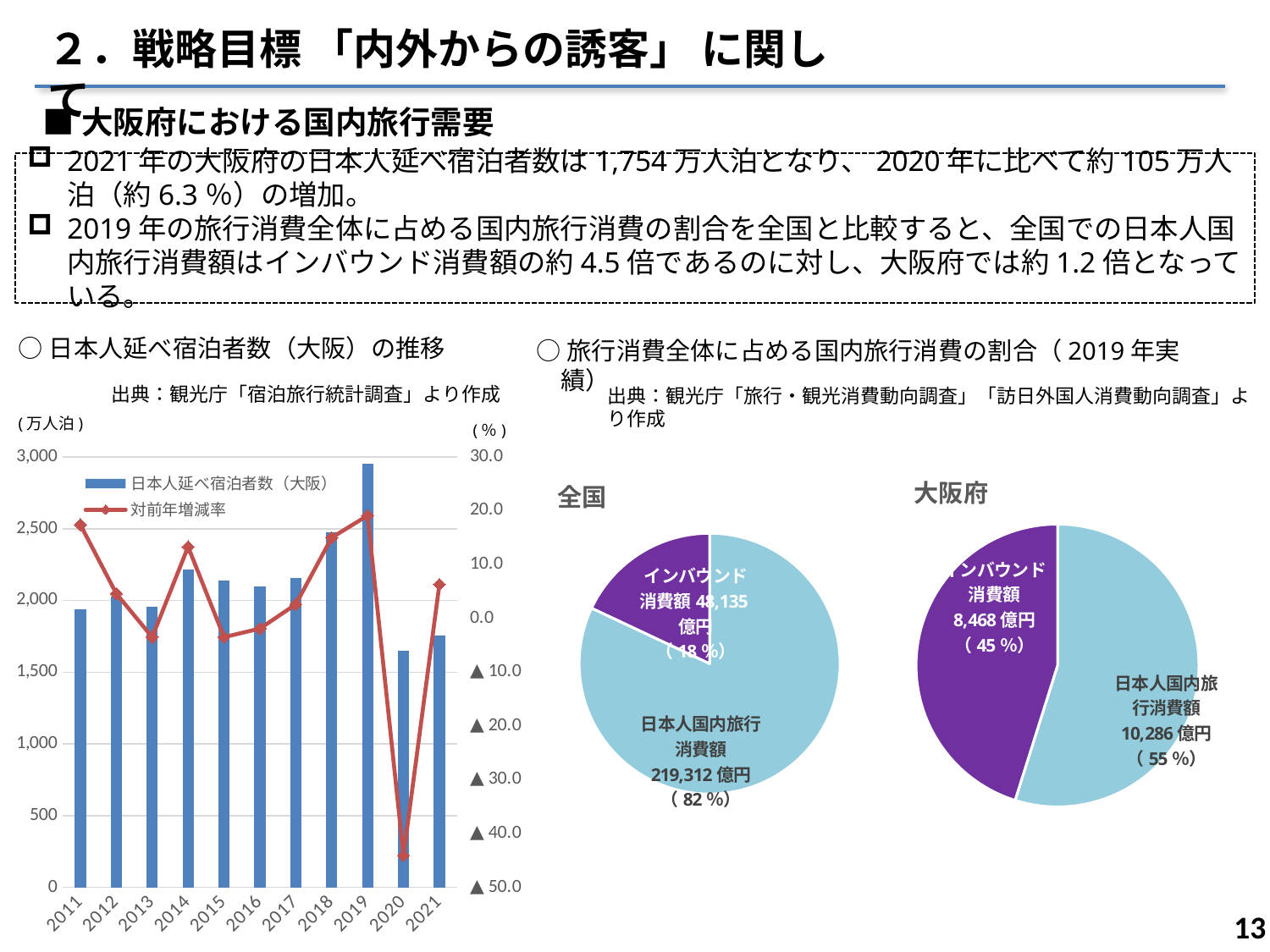
「日本人延べ宿泊者数（大阪）の推移」のグラフには、何年分のデータが表示されていますか？ 11 「日本人延べ宿泊者数（大阪）の推移」のグラフで、日本人延べ宿泊者数が最も少ない年はどれですか？ 2020 「日本人延べ宿泊者数（大阪）の推移」のグラフで、2020年の日本人延べ宿泊者数は2,000万人泊より多いですか、少ないですか？ 少ない 「大阪府」の円グラフで、インバウンド消費額の割合は何％ですか？ 45% 「日本人延べ宿泊者数（大阪）の推移」のグラフで、日本人延べ宿泊者数が最も多い年はどれですか？ 2019 「大阪府」の円グラフで、日本人国内旅行消費額はいくらですか？ 10,286億円 「日本人延べ宿泊者数（大阪）の推移」のグラフで、2018年と2020年では、どちらの日本人延べ宿泊者数が多いですか？ 2018 「全国」の円グラフで、日本人国内旅行消費額の割合は何％ですか？ 82% 「日本人延べ宿泊者数（大阪）の推移」のグラフは、どのような種類のグラフですか？ 棒グラフと折れ線グラフの複合グラフ 「日本人延べ宿泊者数（大阪）の推移」のグラフの凡例には、いくつの系列がありますか？ 2 「全国」の円グラフで、インバウンド消費額はいくらですか？ 48,135億円 「日本人延べ宿泊者数（大阪）の推移」のグラフで、2019年の日本人延べ宿泊者数は2,500万人泊より多いですか、少ないですか？ 多い